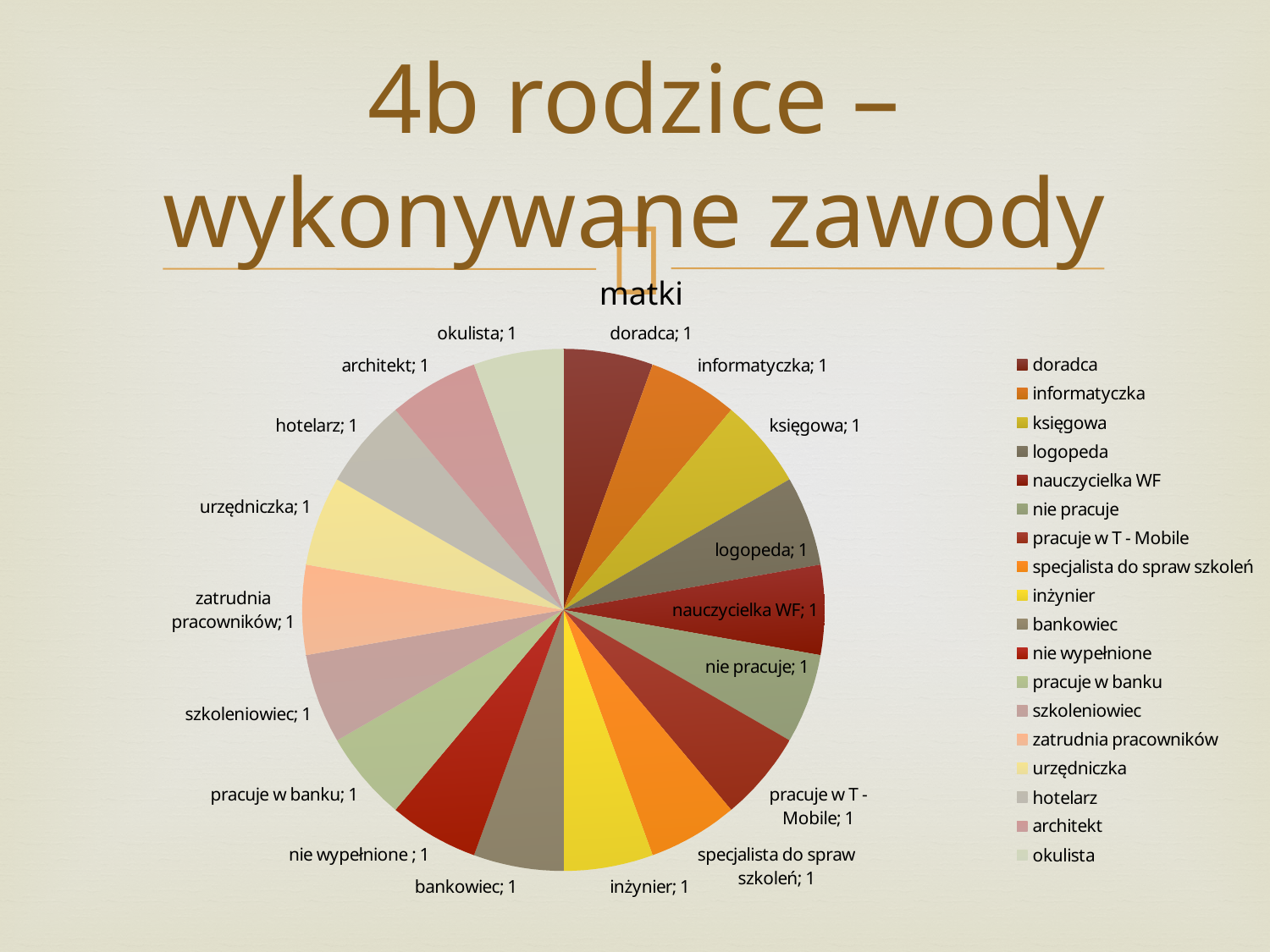
What is the title of the chart? matki What is the value shown for the slice labelled 'doradca'? 1 What is the value shown for the slice labelled 'okulista'? 1 Is the value for 'architekt' larger than, smaller than, or equal to the value for 'hotelarz'? equal What is the total of all the values shown on the pie chart? 18 How many slices does the pie chart have? 18 What is the difference between the value for 'księgowa' and the value for 'inżynier'? 0 What kind of chart is shown on the slide? pie chart What is the value shown for the slice labelled 'nauczycielka WF'? 1 Which legend entry is listed first? doradca How many entries does the legend list? 18 What is the value shown for the slice labelled 'pracuje w T - Mobile'? 1